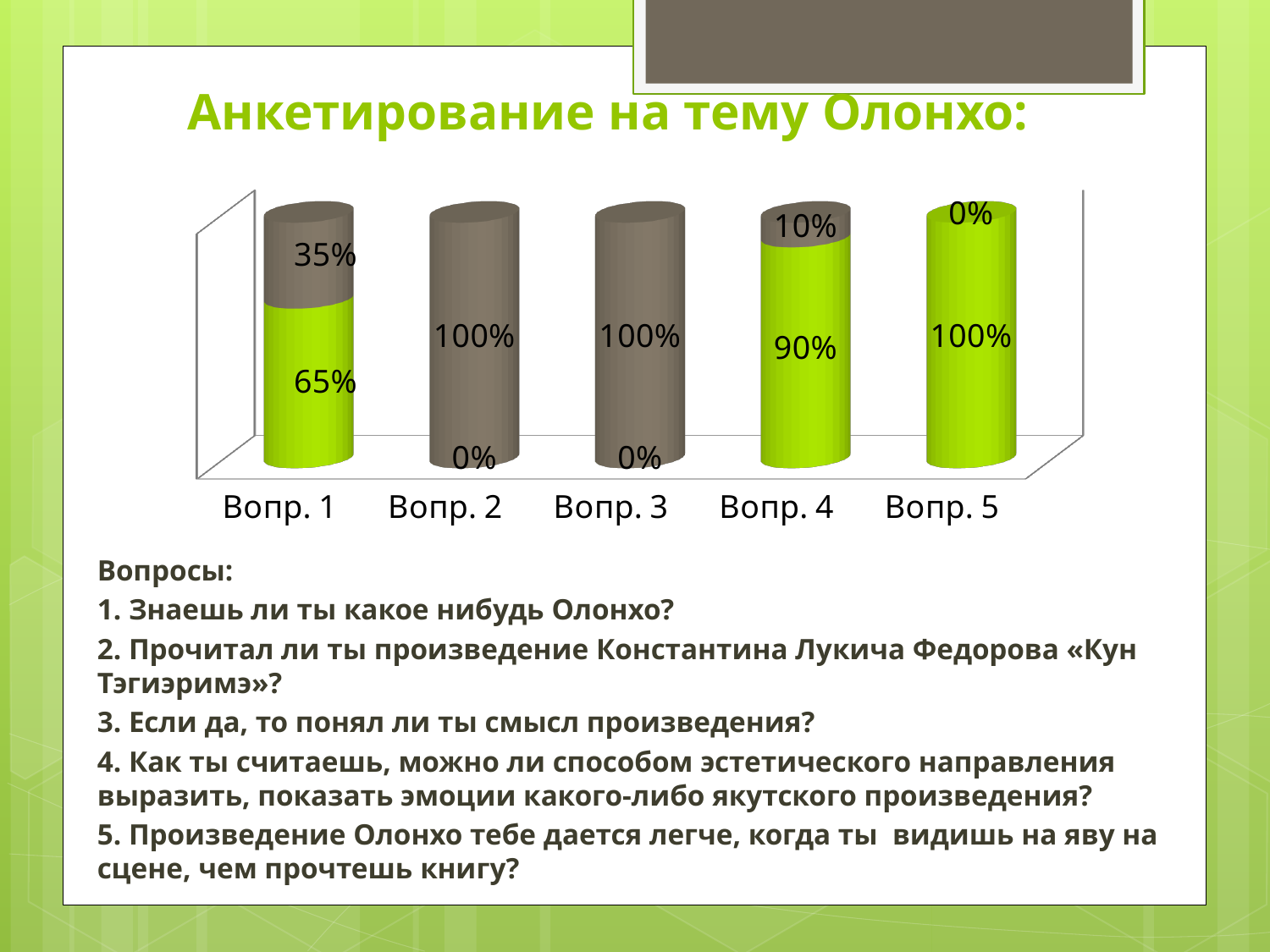
What is the value of the green segment for Вопр. 4? 90% What is the title of the chart on the slide? Анкетирование на тему Олонхо: What is the difference between the green segments of Вопр. 4 and Вопр. 1? 25% Which has the larger green segment, Вопр. 1 or Вопр. 4? Вопр. 4 How many categories are shown on the x axis of the chart? 5 Which category has the largest green segment? Вопр. 5 What is the value of the brown segment for Вопр. 2? 100% What is the value of the green segment for Вопр. 1? 65% What is the value of the brown segment for Вопр. 4? 10% What is the value of the brown segment for Вопр. 1? 35% What kind of chart is shown on the slide? Bar chart What is the value of the green segment for Вопр. 5? 100%